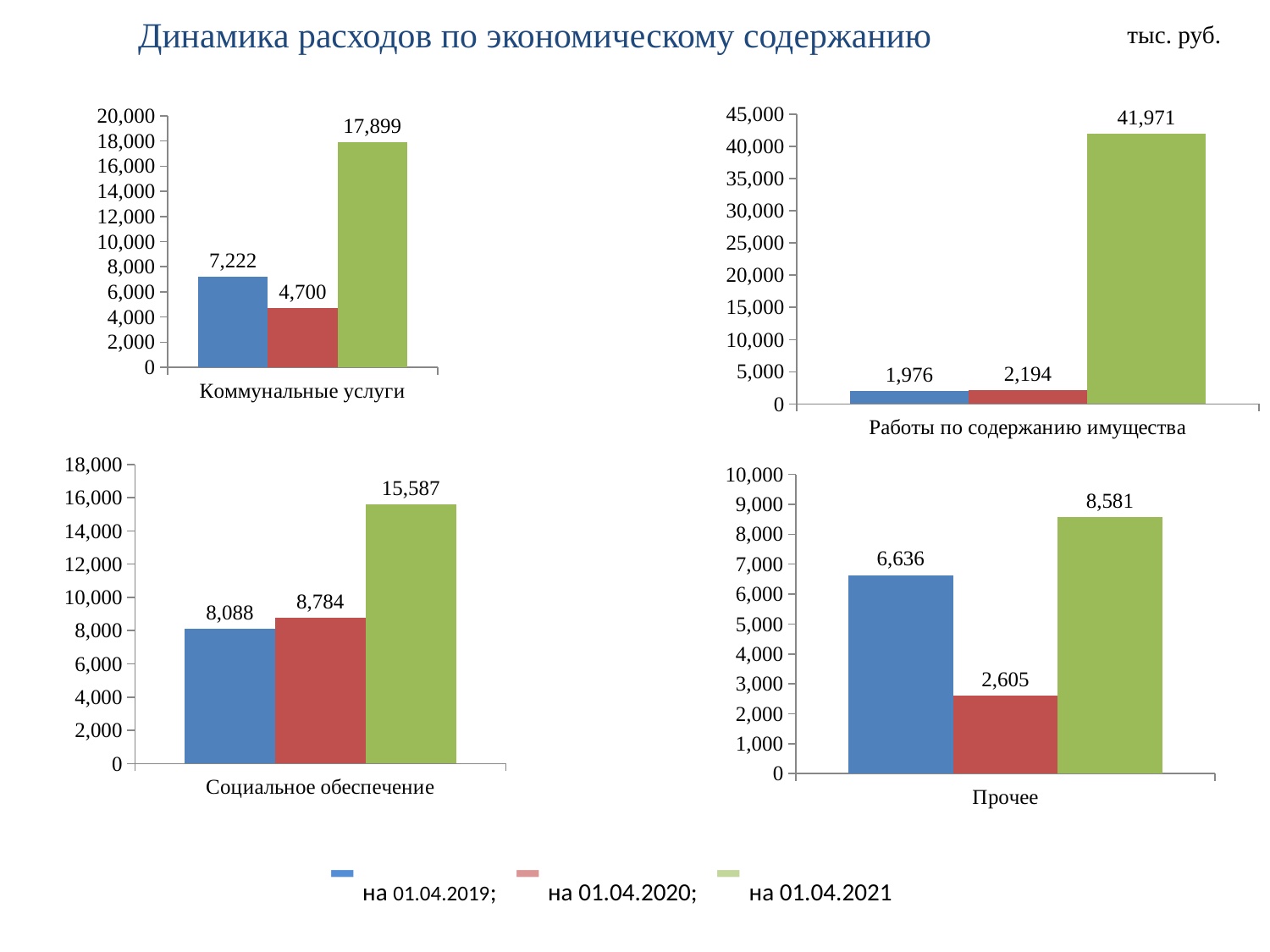
In the 'Прочее' chart, what is the value for на 01.04.2020? 2,605 In the 'Работы по содержанию имущества' chart, is the value for на 01.04.2021 greater or less than 40,000? greater In the 'Социальное обеспечение' chart, which is larger: the value for на 01.04.2019 or на 01.04.2020? на 01.04.2020 In the 'Прочее' chart, what is the difference between the values for на 01.04.2021 and на 01.04.2019? 1,945 In the 'Коммунальные услуги' chart, what is the value for на 01.04.2021? 17,899 In the 'Коммунальные услуги' chart, which date has the lowest value? на 01.04.2020 In the 'Работы по содержанию имущества' chart, what is the value for на 01.04.2019? 1,976 In the 'Социальное обеспечение' chart, which date has the highest value? на 01.04.2021 What type of chart is the 'Социальное обеспечение' chart? bar chart How many series does the legend at the bottom of the slide list? 3 In the 'Работы по содержанию имущества' chart, do the values rise or fall from на 01.04.2019 to на 01.04.2021? rise How many bars are shown in the 'Прочее' chart? 3